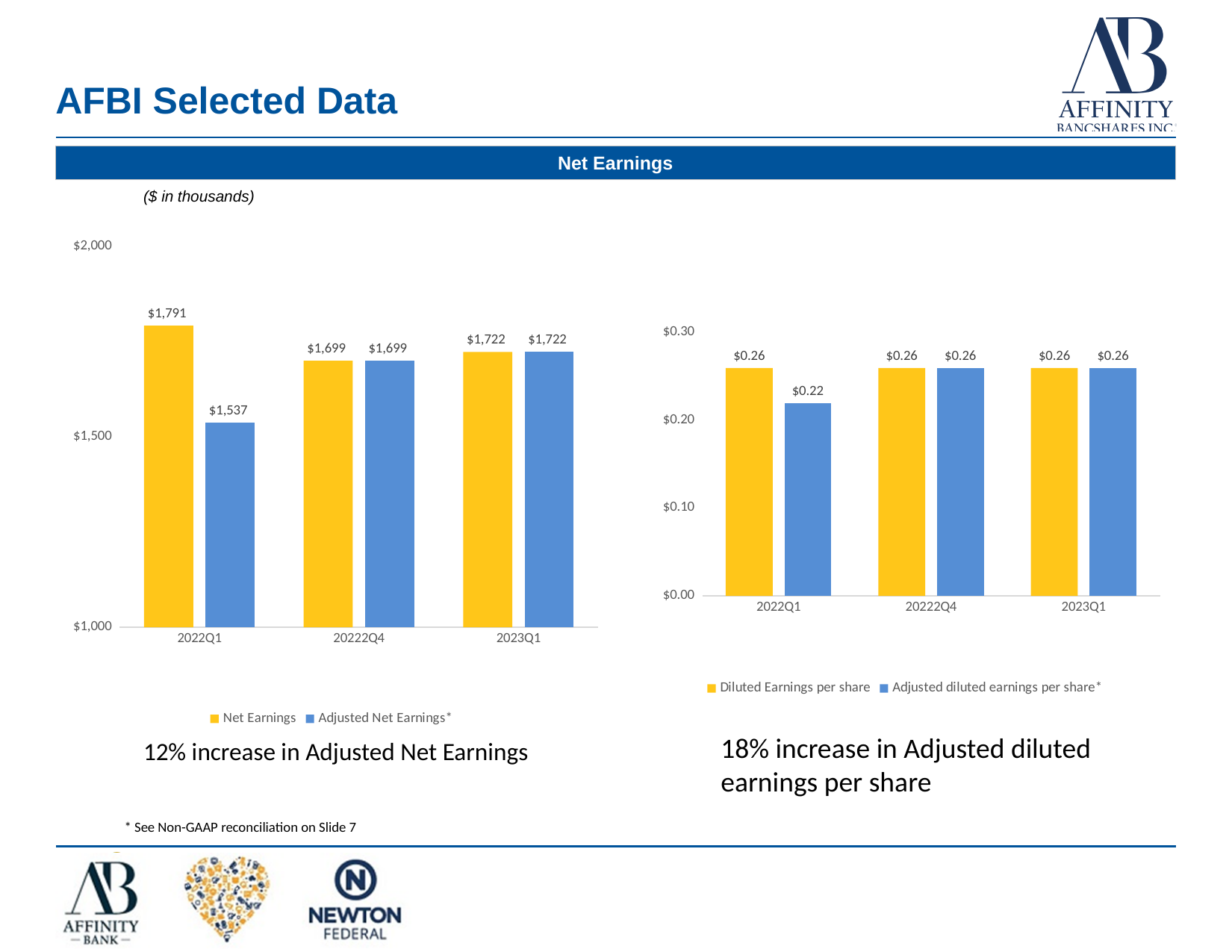
On the left chart (Net Earnings), which quarter has the lowest Adjusted Net Earnings? 2022Q1 On the left chart (Net Earnings), what is the difference between Net Earnings and Adjusted Net Earnings in 2022Q1? $254 On the right chart (earnings per share), is the Adjusted diluted earnings per share for 2022Q1 greater or less than $0.20? greater On the left chart (Net Earnings), what is the Net Earnings value for 2022Q1? $1,791 On the left chart (Net Earnings), how many series does the legend list? 2 On the right chart (earnings per share), how many quarters are shown on the x axis? 3 On the left chart (Net Earnings), what is the Adjusted Net Earnings value for 2023Q1? $1,722 On the right chart (earnings per share), what is the Adjusted diluted earnings per share for 2022Q1? $0.22 What kind of chart is the right chart (earnings per share)? Bar chart On the right chart (earnings per share), what is the Diluted Earnings per share for 2023Q1? $0.26 On the left chart (Net Earnings), what is the Adjusted Net Earnings value for 2022Q1? $1,537 On the left chart (Net Earnings), which quarter has the highest Net Earnings? 2022Q1